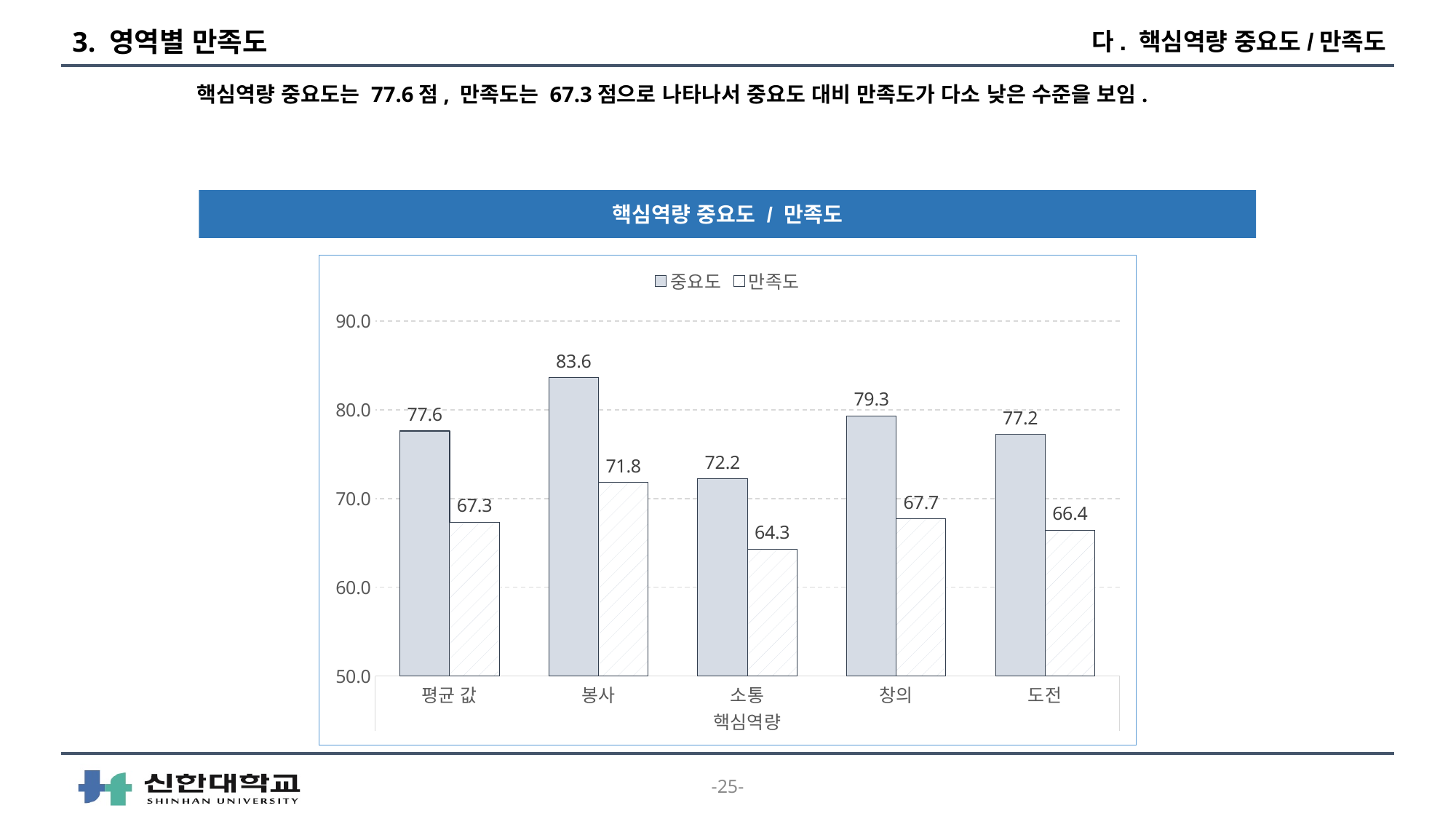
How many categories are shown on the x axis? 5 Which category has the lowest 만족도 value? 소통 How many series does the legend list? 2 What is the 중요도 value for 봉사? 83.6 What is the 만족도 value for 소통? 64.3 What is the difference between the 중요도 and 만족도 values for 창의? 11.6 Which category has the highest 중요도 value? 봉사 What is the title of the chart? 핵심역량 중요도 / 만족도 Which is larger, the 중요도 value for 소통 or the 중요도 value for 도전? 도전 What is the 만족도 value for 도전? 66.4 Is the 만족도 value for 봉사 greater or less than 70.0? greater What kind of chart is shown on the slide? bar chart